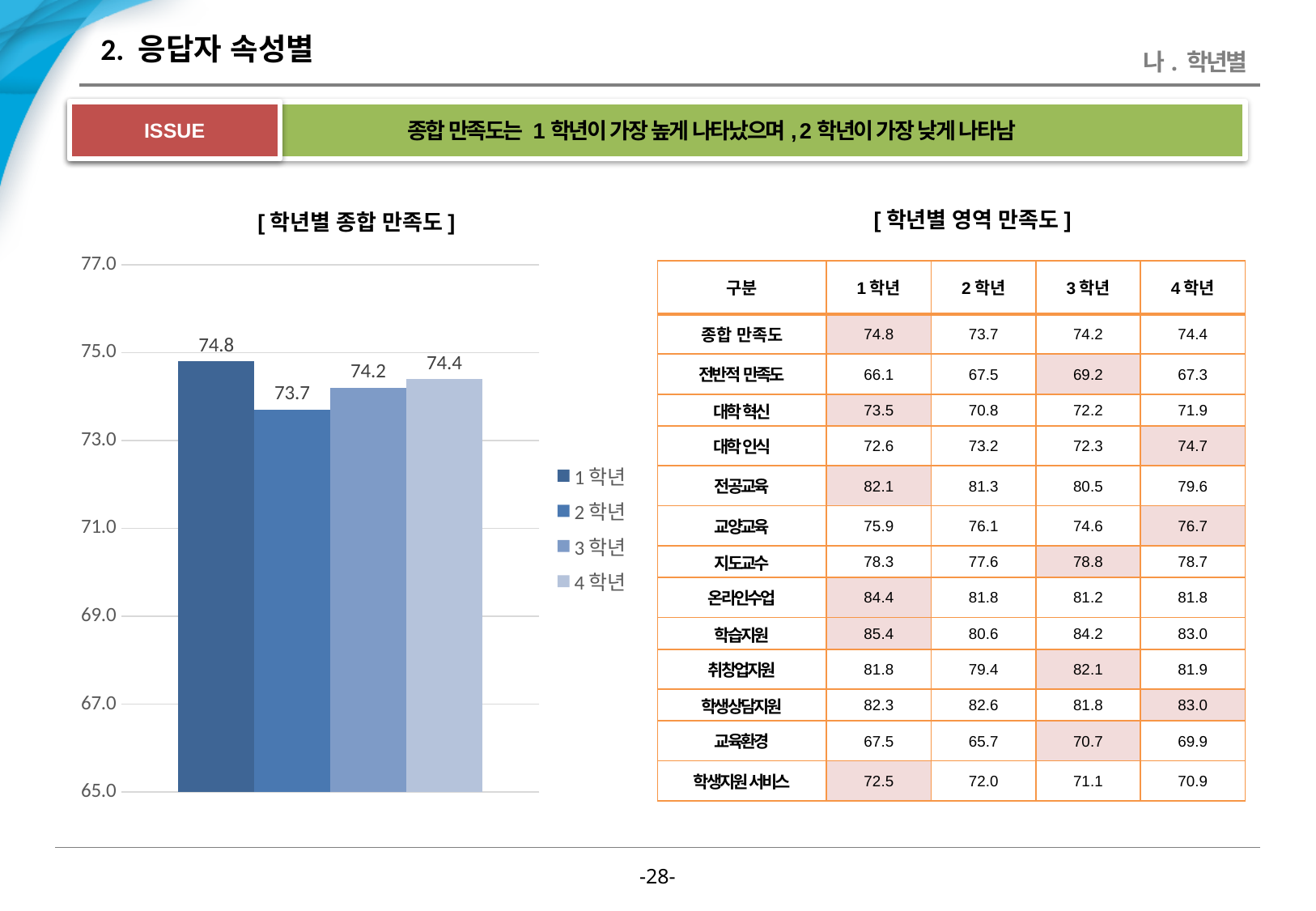
In the [ 학년별 종합 만족도 ] chart, which is larger, the value for 3 학년 or 4 학년? 4 학년 What is the value for 3 학년 in the [ 학년별 종합 만족도 ] chart? 74.2 Which grade has the highest value in the [ 학년별 종합 만족도 ] chart? 1 학년 What is the value for 1 학년 in the [ 학년별 종합 만족도 ] chart? 74.8 How many bars are plotted in the [ 학년별 종합 만족도 ] chart? 4 What is the value for 4 학년 in the [ 학년별 종합 만족도 ] chart? 74.4 What kind of chart is the [ 학년별 종합 만족도 ] chart? bar chart Which grade has the lowest value in the [ 학년별 종합 만족도 ] chart? 2 학년 What is the value for 2 학년 in the [ 학년별 종합 만족도 ] chart? 73.7 How many entries does the legend of the [ 학년별 종합 만족도 ] chart list? 4 What is the difference between the values for 1 학년 and 2 학년 in the [ 학년별 종합 만족도 ] chart? 1.1 In the [ 학년별 종합 만족도 ] chart, is the value for 2 학년 greater or less than 75.0? less